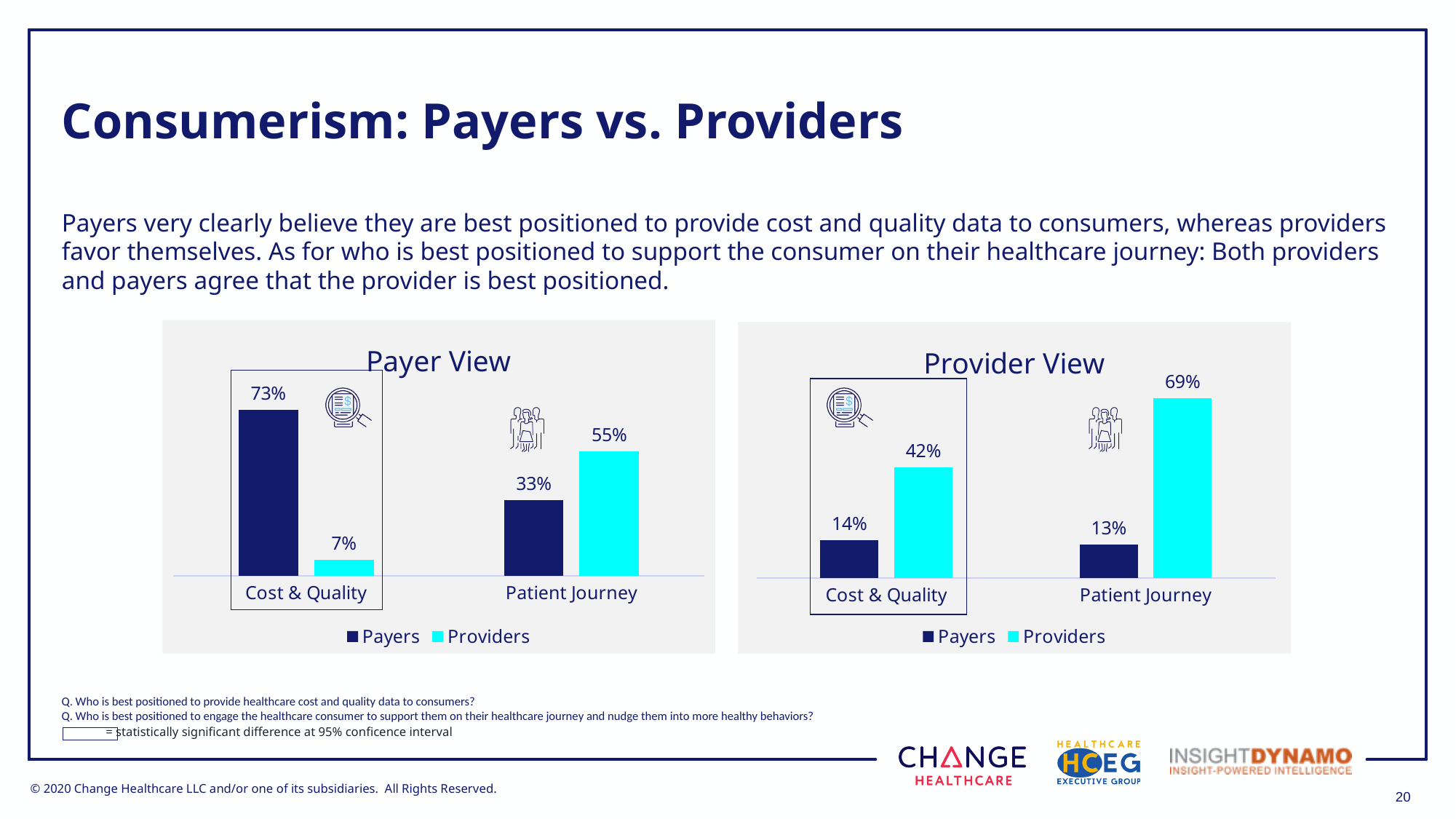
In the Provider View chart, what is the difference between the Providers and Payers values for Patient Journey? 56% In the Payer View chart, what is the difference between the Payers and Providers values for Cost & Quality? 66% How many series does the legend of the Provider View chart list? 2 In the Payer View chart, which series has the higher value for Patient Journey? Providers What kind of chart is the Provider View chart? Bar chart In the Payer View chart, which bar has the lowest value? Providers, Cost & Quality In the Provider View chart, what is the value for Payers under Patient Journey? 13% In the Provider View chart, which bar has the highest value? Providers, Patient Journey In the Payer View chart, what is the value for Payers under Cost & Quality? 73% In the Payer View chart, what is the value for Providers under Patient Journey? 55% In the Provider View chart, what is the value for Providers under Cost & Quality? 42% How many categories are shown on the x axis of the Payer View chart? 2